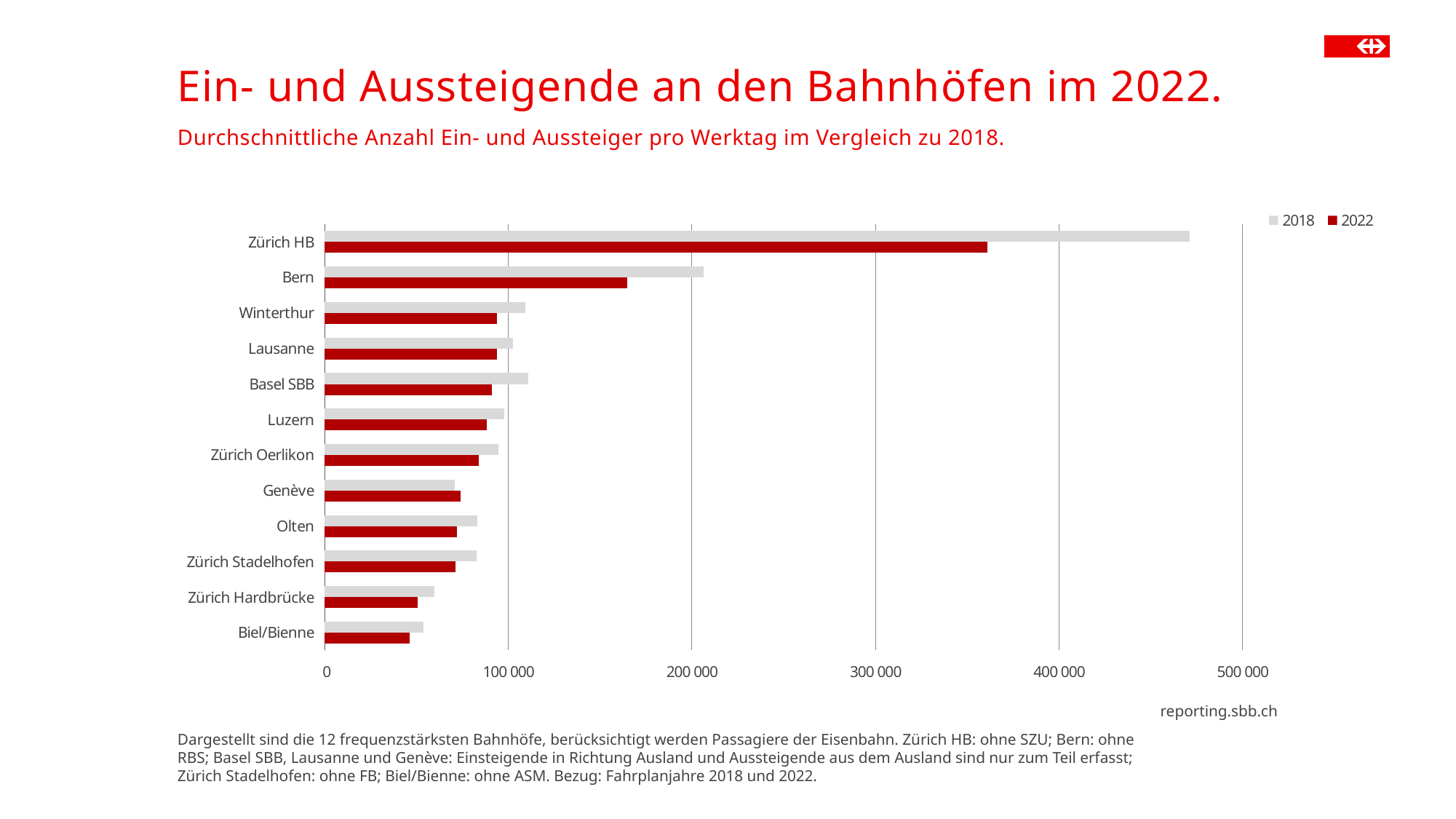
Is the 2022 value for Zürich HB greater or less than 300 000? greater For Genève, which year has the larger value, 2018 or 2022? 2022 Is the 2018 value for Bern greater or less than 200 000? greater Is the 2022 value for Bern greater or less than 200 000? less Which colour represents the 2022 series in the legend? Red Which station has the highest value for 2022? Zürich HB For Zürich HB, which year has the larger value, 2018 or 2022? 2018 How many series does the legend list? 2 How many stations are shown on the chart? 12 Which station has the lowest value for 2018? Biel/Bienne What kind of chart is shown on the slide? Bar chart